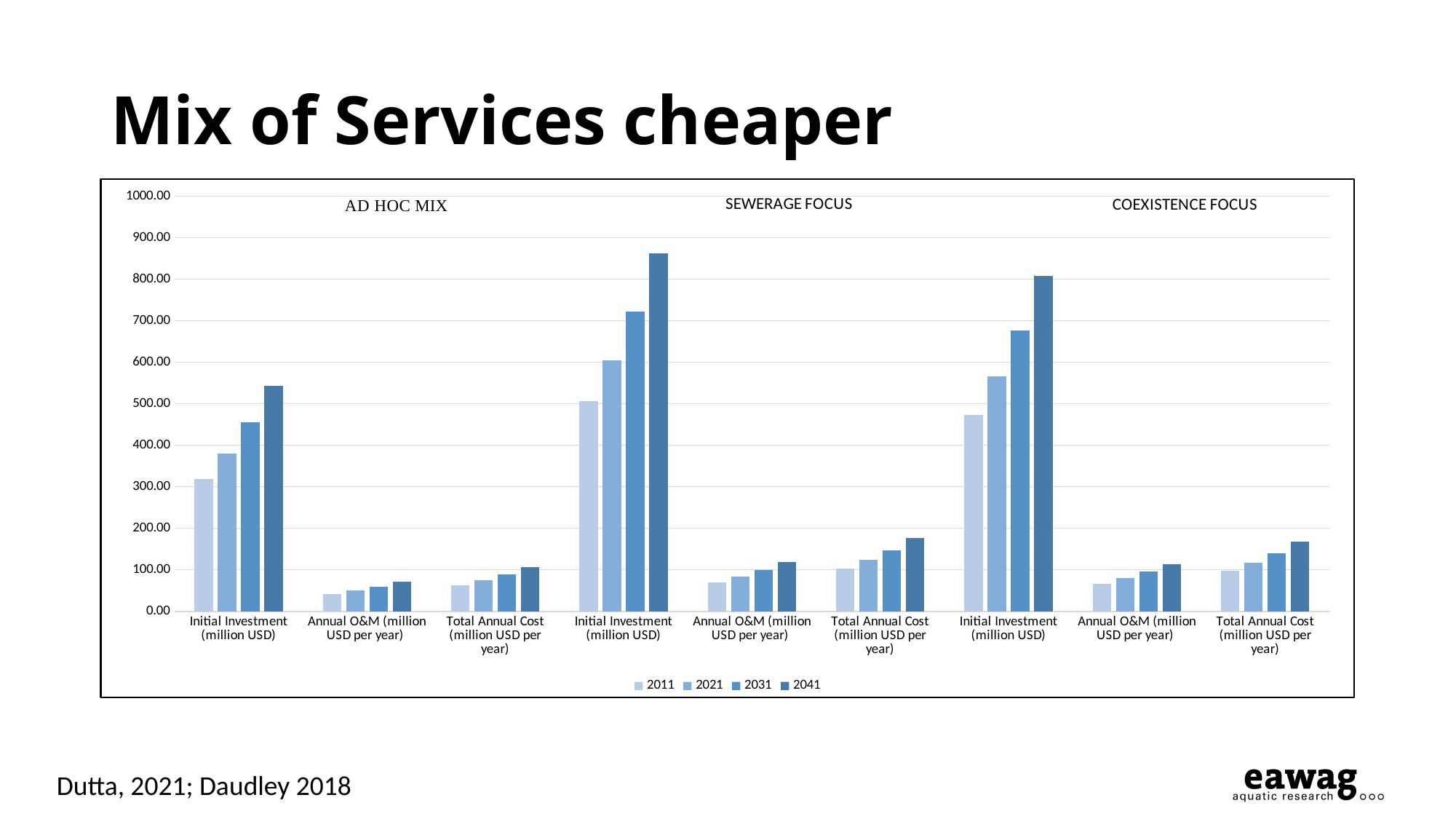
What kind of chart is shown on the slide? bar chart How many category groups are shown along the x axis? 9 Which is larger: the 2041 Initial Investment under AD HOC MIX or the 2041 Initial Investment under COEXISTENCE FOCUS? COEXISTENCE FOCUS Which years are listed in the legend? 2011, 2021, 2031, 2041 How many series does the legend list? 4 Which bar is the lowest in the whole chart? Annual O&M (million USD per year) for 2011 under AD HOC MIX What are the three scenario labels written across the top of the chart? AD HOC MIX, SEWERAGE FOCUS, COEXISTENCE FOCUS Is the 2041 Initial Investment value under AD HOC MIX greater or less than 500? greater Is the 2011 Initial Investment value under COEXISTENCE FOCUS greater or less than 500? less Which bar is the tallest in the whole chart? Initial Investment (million USD) for 2041 under SEWERAGE FOCUS Within the Initial Investment group under SEWERAGE FOCUS, do the values rise or fall from 2011 to 2041? rise Is the 2041 Initial Investment value under SEWERAGE FOCUS greater or less than 800? greater